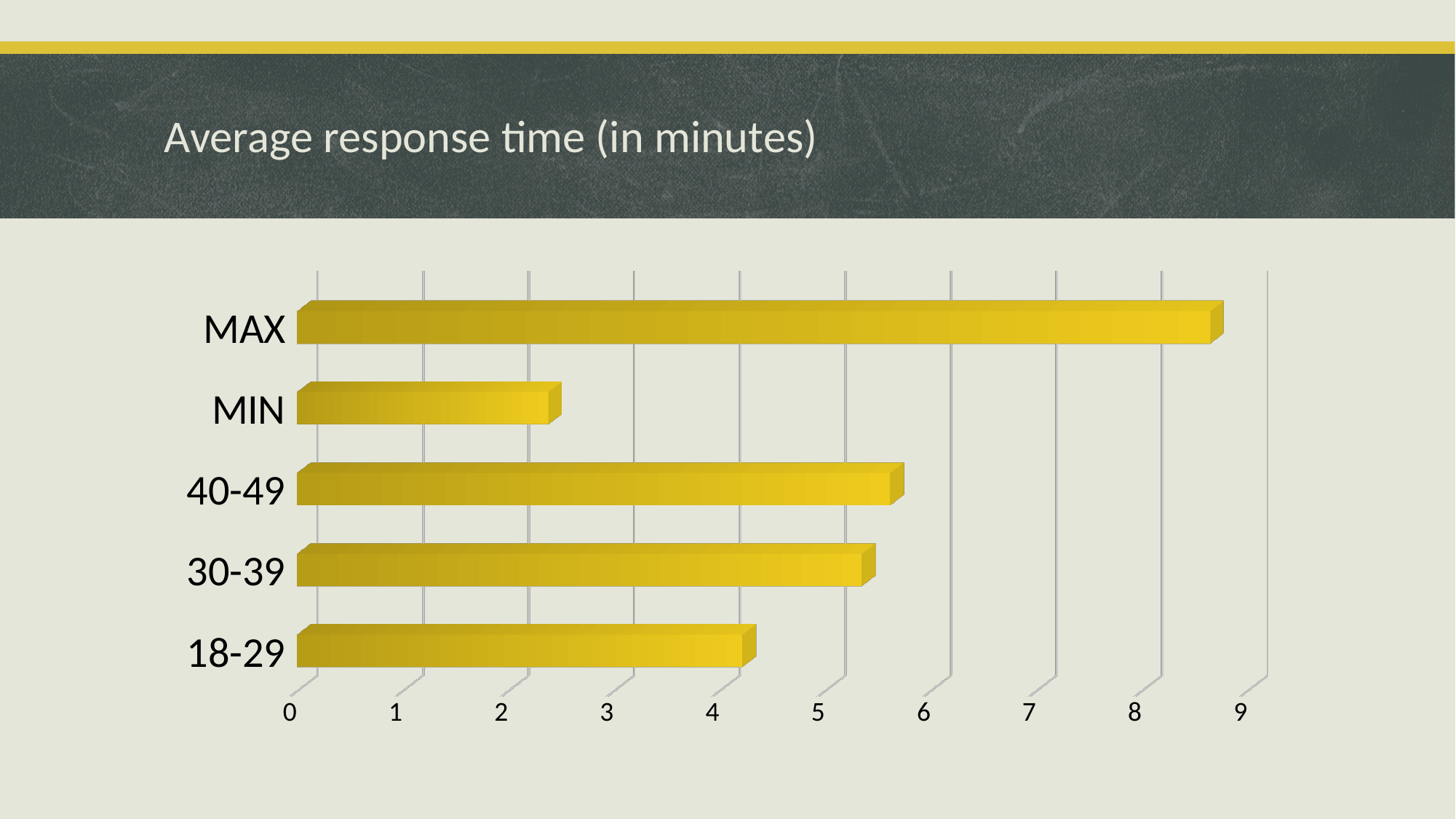
Is the value for 30-39 greater or less than 5? greater Which has a larger value, 30-39 or 18-29? 30-39 Which category has the lowest average response time? MIN Is the value for MAX greater or less than 8? greater Which category has the highest average response time? MAX How many categories are shown on the chart? 5 Is the value for MIN greater or less than 3? less What is the title of the chart? Average response time (in minutes) What type of chart is shown on the slide? bar chart Which has a larger value, 18-29 or 40-49? 40-49